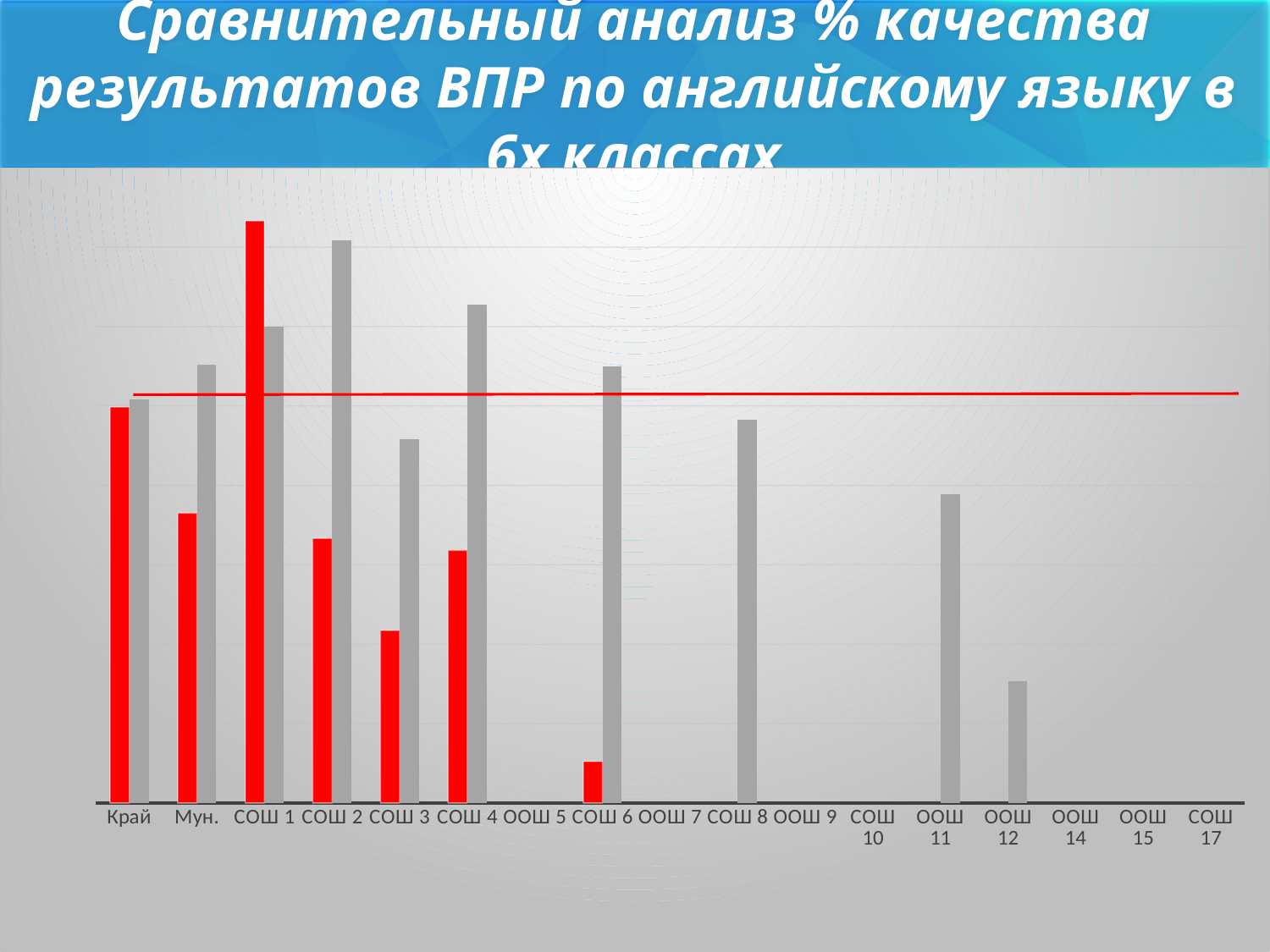
Which is taller: the red bar for СОШ 1 or the red bar for Мун.? СОШ 1 Which is taller: the red bar for Край or the red bar for СОШ 3? Край Which is taller: the grey bar for ООШ 11 or the grey bar for СОШ 4? СОШ 4 What kind of chart is shown on the slide? bar chart Which category has the tallest red bar? СОШ 1 How many categories are labelled along the x axis of the chart? 17 Which category has the tallest grey bar? СОШ 2 What two colours are used for the bars in the chart? red and grey Among the categories that have a red bar, which has the shortest red bar? СОШ 6 Which subject is named in the chart's title? английский язык